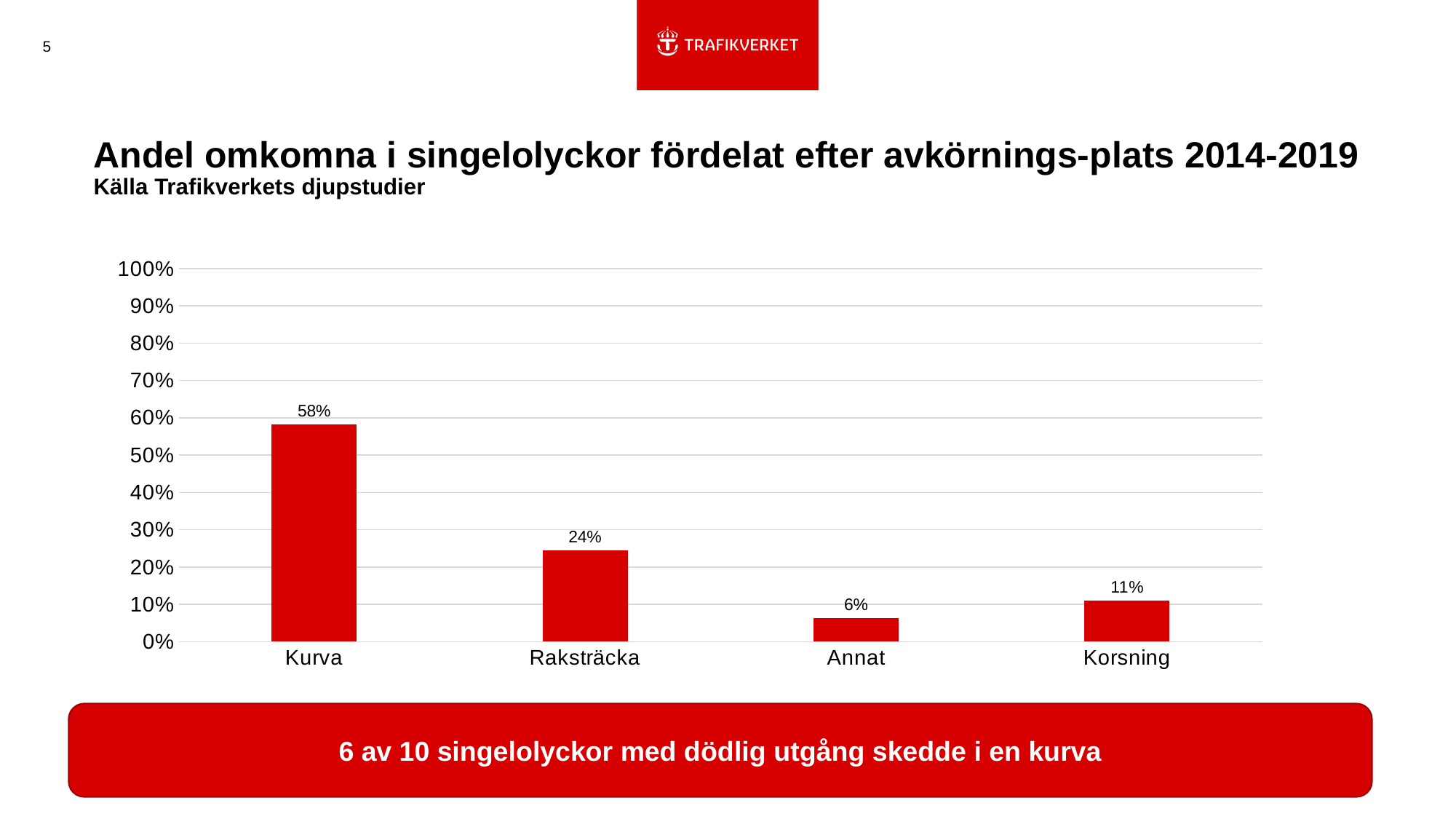
What is the title of the chart on the slide? Andel omkomna i singelolyckor fördelat efter avkörnings-plats 2014-2019 How many categories are shown on the x axis? 4 What kind of chart is shown on the slide? Bar chart What is the difference between the values for Korsning and Annat? 5% What is the value for Annat? 6% What is the value for Raksträcka? 24% Which category has the highest value? Kurva Which category has the lowest value? Annat What is the value for Korsning? 11% What is the difference between the values for Kurva and Raksträcka? 34% What is the value for Kurva? 58% Which is larger, the value for Raksträcka or the value for Korsning? Raksträcka